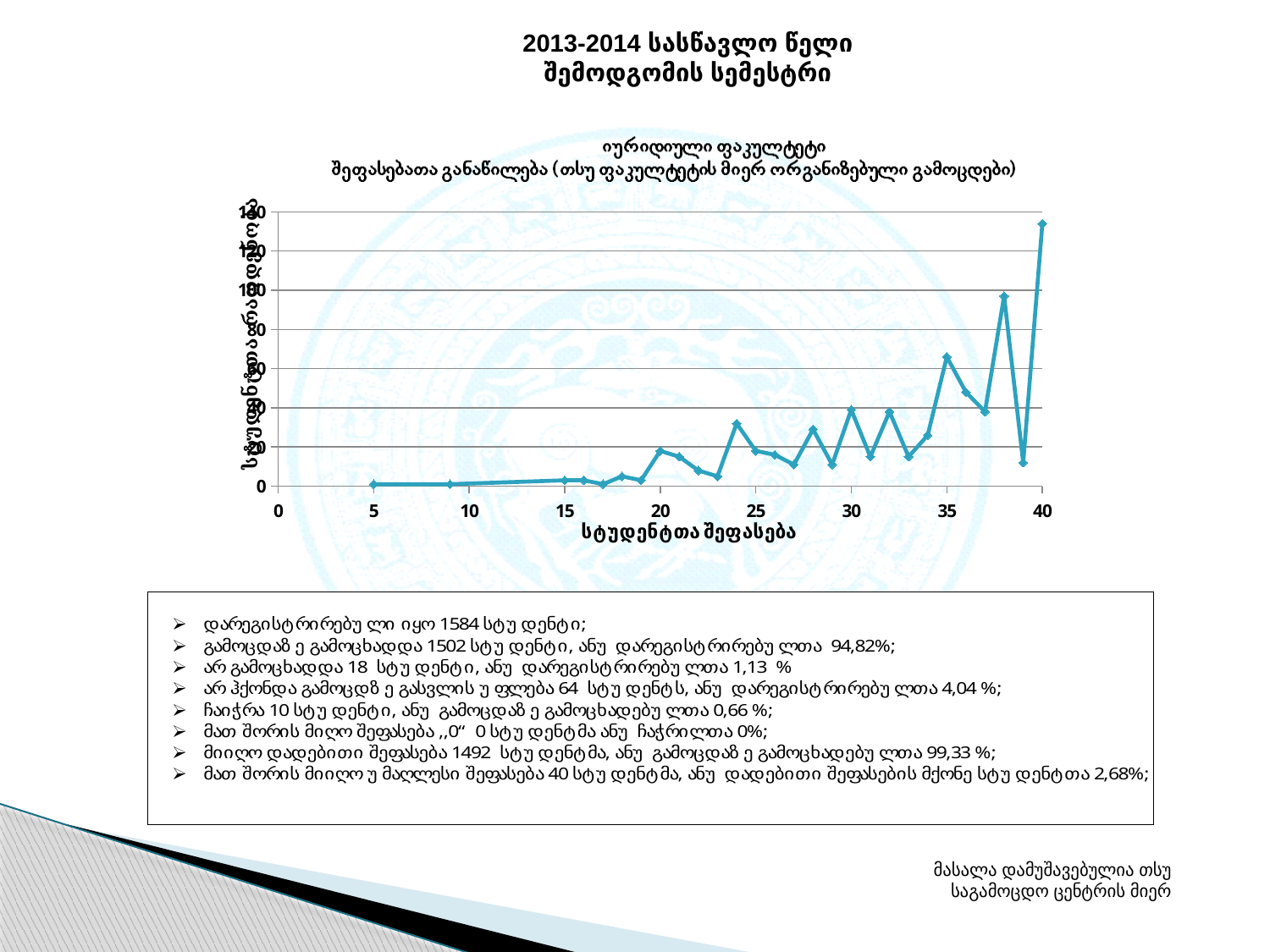
Is the value at x = 30 greater or less than 60? less Is the value at x = 38 greater or less than 80? greater Is the value at x = 39 greater or less than 20? less Overall, do the values rise or fall as the x axis increases from 5 to 40? rise What is the first line of the chart title? იურიდიული ფაკულტეტი At which value on the x axis (სტუდენტთა შეფასება) does the line reach its highest point? 40 What is the title of the x axis? სტუდენტთა შეფასება Which has the larger value: x = 38 or x = 35? x = 38 Which has the larger value: x = 24 or x = 23? x = 24 What kind of chart is shown on the slide? line chart